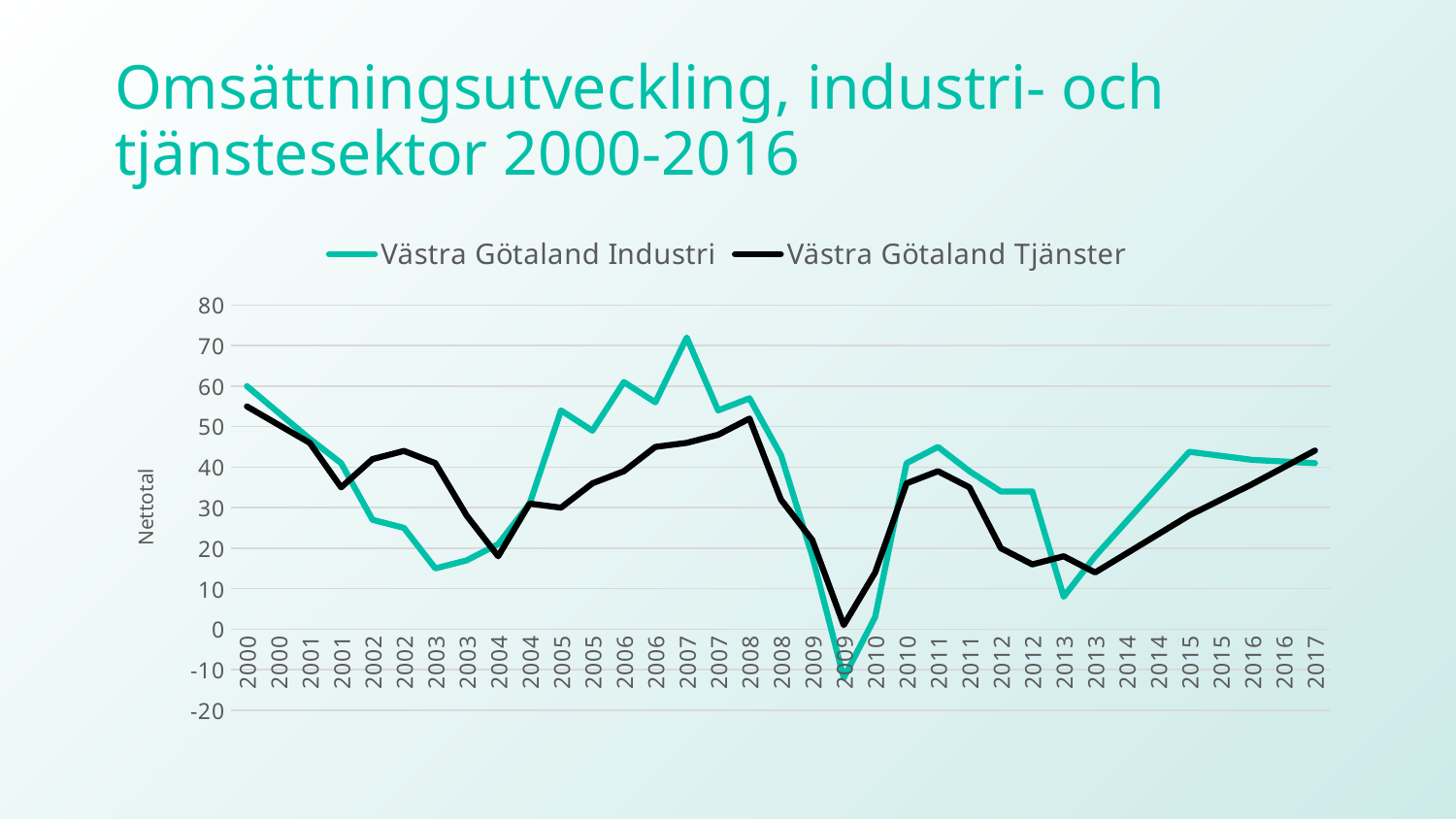
What kind of chart is shown on the slide? Line chart Does the Västra Götaland Tjänster line rise or fall between the second 2013 point and 2017? Rise At which x-axis label does the Västra Götaland Industri line reach its lowest point? 2009 How many series does the legend list? 2 At which x-axis label does the Västra Götaland Industri line reach its highest point? 2007 Is the peak value of Västra Götaland Industri in 2007 greater or less than 60? greater Which series is drawn with the black line? Västra Götaland Tjänster At the first 2013 point, which series has the larger value, Västra Götaland Industri or Västra Götaland Tjänster? Västra Götaland Tjänster Is the lowest value of Västra Götaland Industri in 2009 greater or less than 0? less Is the value of Västra Götaland Tjänster at the first 2000 point greater or less than 50? greater What is the label on the vertical axis? Nettotal At the first 2007 point, which series has the larger value, Västra Götaland Industri or Västra Götaland Tjänster? Västra Götaland Industri